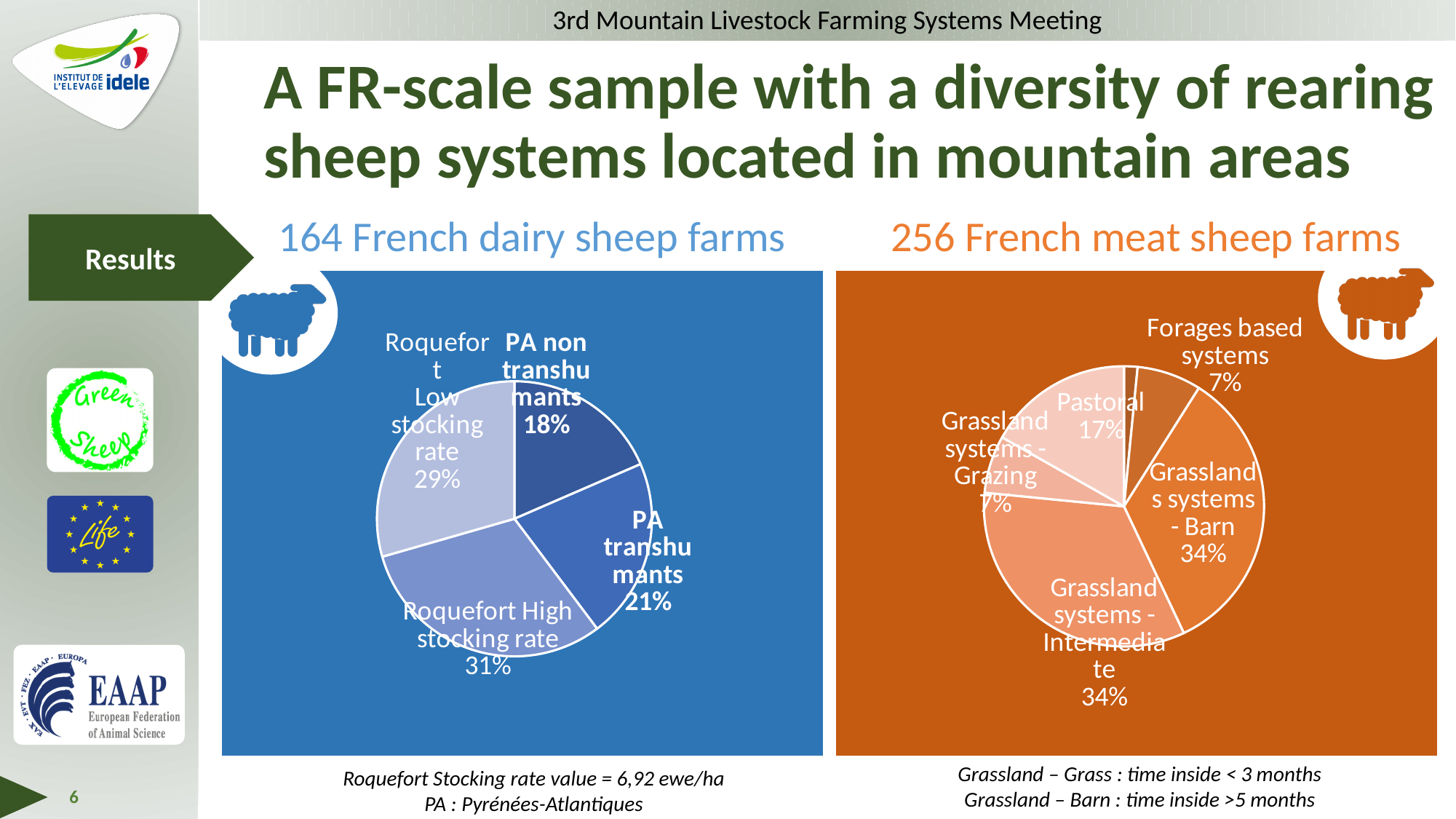
On the pie chart for the 256 French meat sheep farms, which is larger: Pastoral or Grassland systems - Grazing? Pastoral On the pie chart for the 164 French dairy sheep farms, which category has the largest share? Roquefort High stocking rate On the pie chart for the 256 French meat sheep farms, what share is Forages based systems? 7% On the pie chart for the 164 French dairy sheep farms, what share is PA transhumants? 21% On the pie chart for the 164 French dairy sheep farms, what is the difference in percentage points between Roquefort Low stocking rate and PA non transhumants? 11 On the pie chart for the 256 French meat sheep farms, what share is Pastoral? 17% On the pie chart for the 164 French dairy sheep farms, which category has the smallest share? PA non transhumants On the pie chart for the 256 French meat sheep farms, what share is Grassland systems - Barn? 34% What kind of chart is used for the 256 French meat sheep farms? Pie chart On the pie chart for the 164 French dairy sheep farms, what share is Roquefort High stocking rate? 31% On the pie chart for the 164 French dairy sheep farms, how many categories are shown? 4 On the pie chart for the 164 French dairy sheep farms, what share is PA non transhumants? 18%